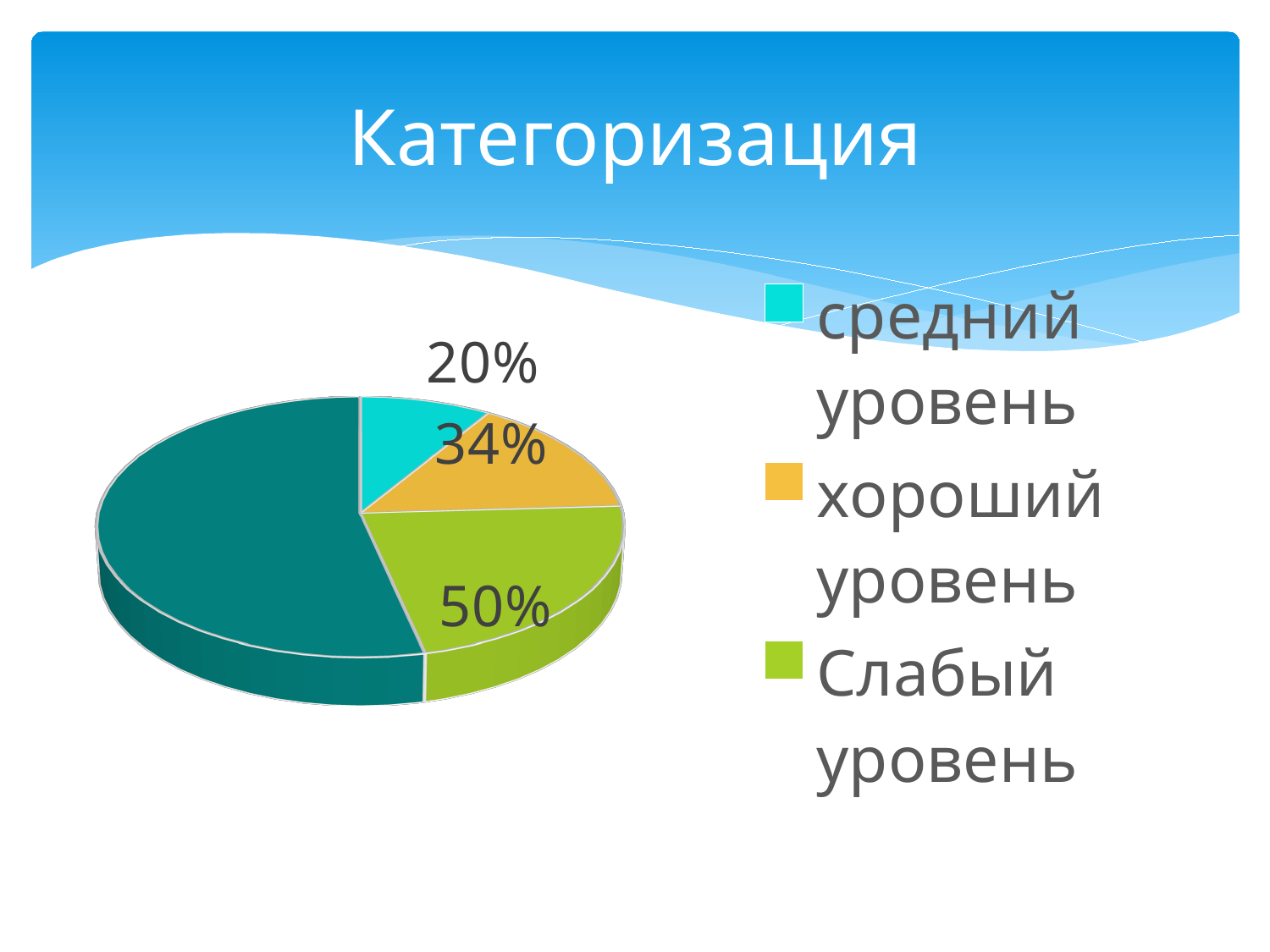
How many entries does the chart legend list? 3 What is the difference between the labelled values for Слабый уровень and хороший уровень? 16% Which legend entry is shown with a green colour? Слабый уровень What value is labelled on the slice for Слабый уровень? 50% What is the difference between the labelled values for хороший уровень and средний уровень? 14% What kind of chart is shown on the slide? pie chart What is the title of the chart? Категоризация Which has the larger labelled value, Слабый уровень or хороший уровень? Слабый уровень What value is labelled on the slice for средний уровень? 20% How many slices are visible in the pie? 4 Which has the larger labelled value, хороший уровень or средний уровень? хороший уровень What value is labelled on the slice for хороший уровень? 34%